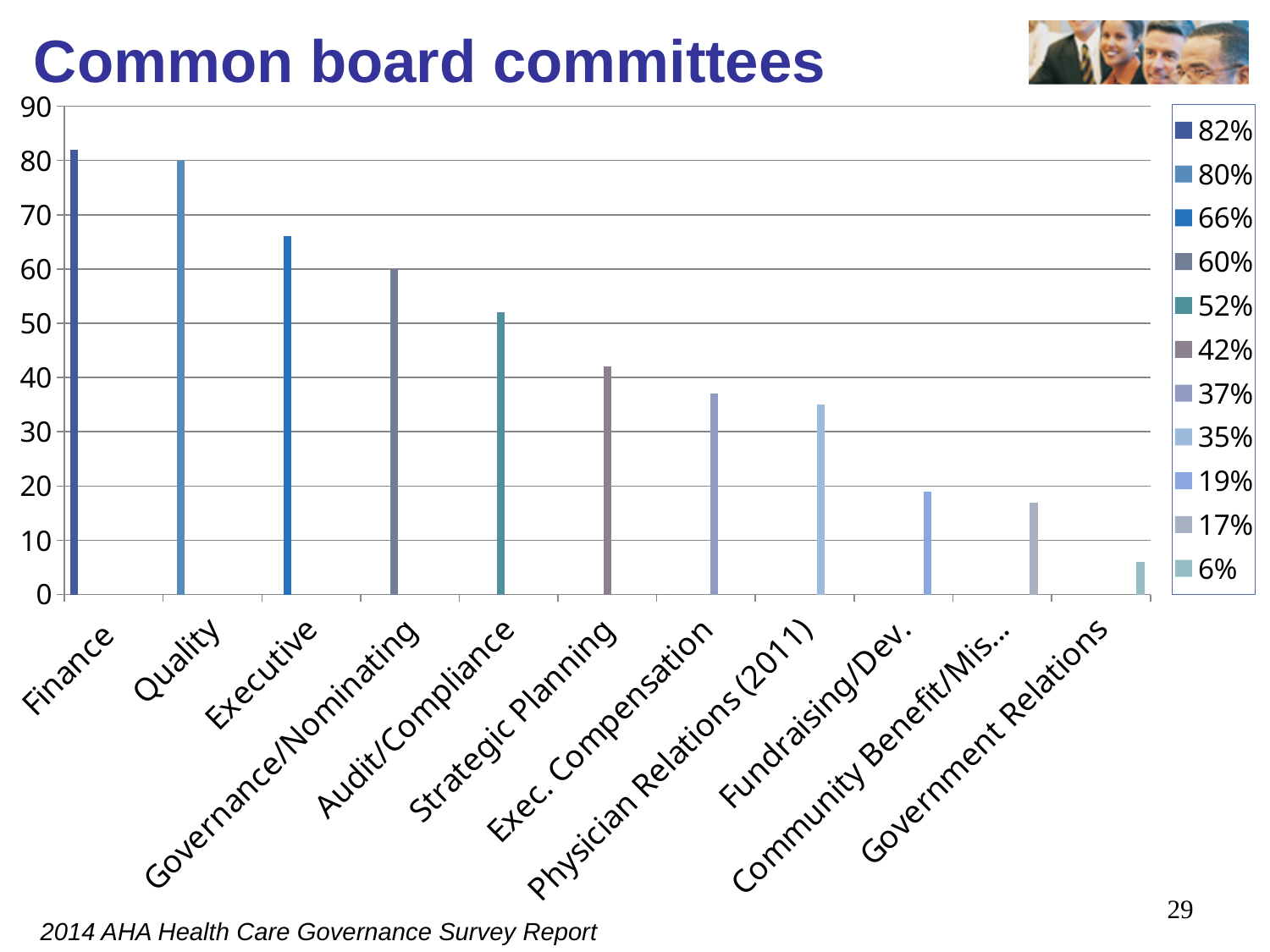
What type of chart is shown on the slide? bar chart How many entries does the legend list? 11 What is the title of the chart? Common board committees Do the values rise or fall moving from left to right along the x axis? fall Which committee has the lowest value? Government Relations Which committee has the highest value? Finance What is the value for Quality? 80% What is the value for Finance? 82% How many committee categories are shown on the x axis? 11 What is the value for Governance/Nominating? 60% Is the value for Strategic Planning greater or less than 40? greater Which is larger, the value for Executive or the value for Audit/Compliance? Executive